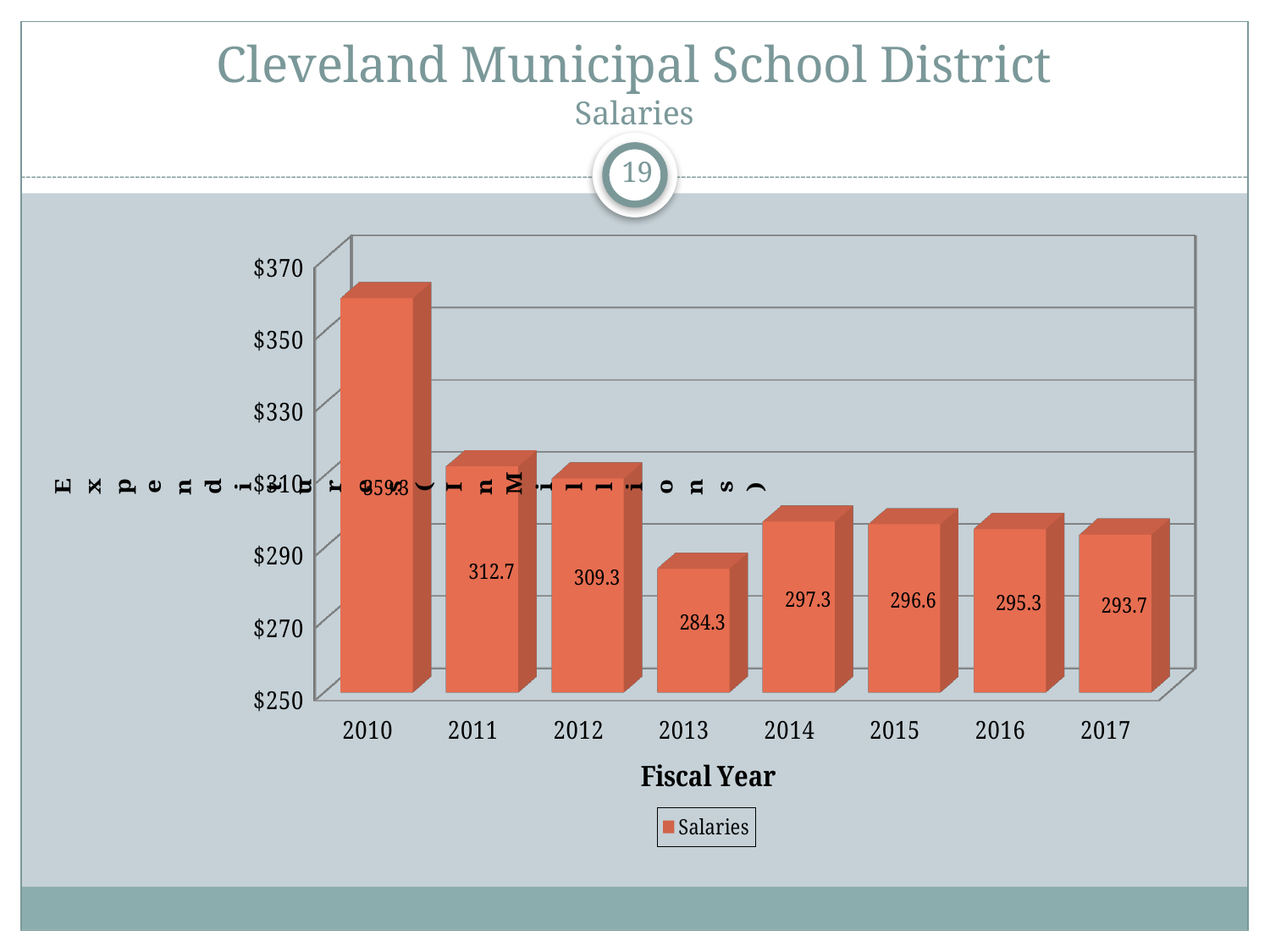
What is the value for 2017? 293.7 Which fiscal year has the highest salaries value? 2010 Is the value for 2010 greater or less than $350? greater What is the value for 2013? 284.3 How many fiscal years are shown on the x axis? 8 What is the difference between the values for 2014 and 2013? 13.0 Which fiscal year has the lowest salaries value? 2013 What is the value for 2011? 312.7 What is the difference between the values for 2011 and 2012? 3.4 What kind of chart is shown on the slide? bar chart What is the x-axis title of the chart? Fiscal Year Which is larger, the value for 2012 or the value for 2016? 2012